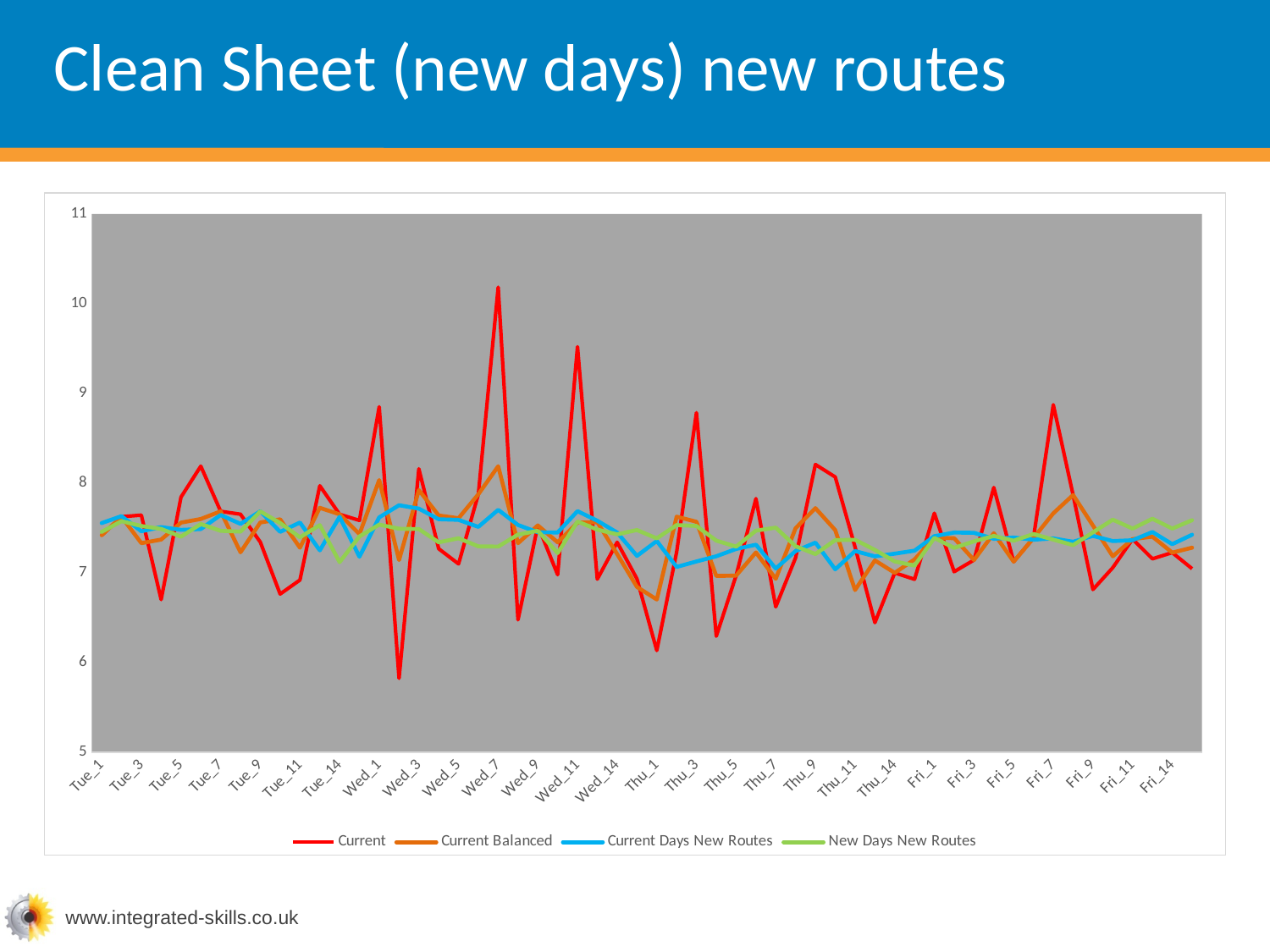
Which series reaches the lowest value anywhere on the chart? Current Is the value of the Current series at Thu_3 greater or less than 8? greater Is the value of the Current series at Wed_3 greater or less than 6? greater What is the highest value shown on the vertical axis? 11 Which series reaches the highest value anywhere on the chart? Current Is the value of the Current series at Fri_7 greater or less than 8? greater How many series does the legend list? 4 At Wed_7, which series has the larger value, Current or New Days New Routes? Current What colour is the line for the Current series? red What kind of chart is shown on the slide? line chart